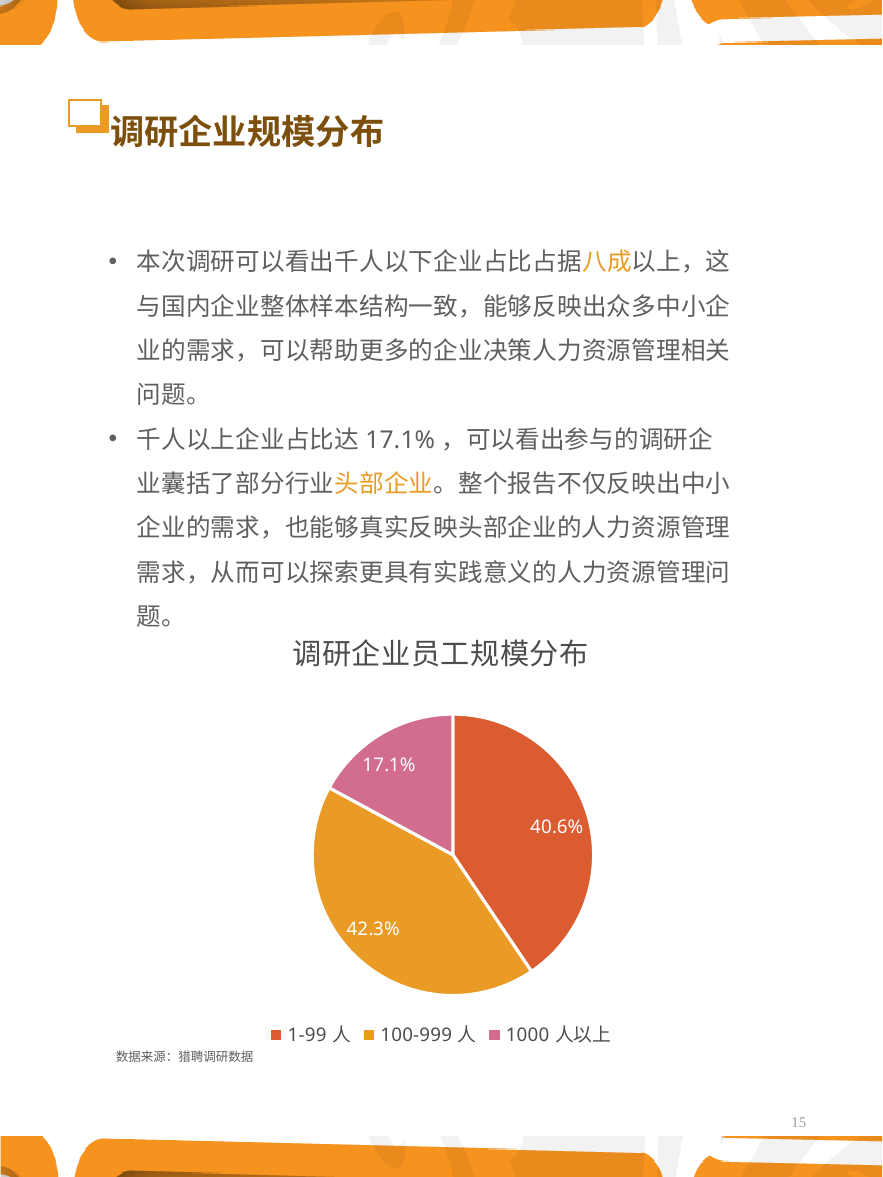
How many categories are listed in the legend? 3 What share of surveyed companies have 1-99 employees (1-99 人)? 40.6% What is the title of the chart? 调研企业员工规模分布 What is the combined share of companies with fewer than 1000 employees (1-99 人 and 100-999 人)? 82.9% What share of surveyed companies have 1000 or more employees (1000 人以上)? 17.1% Which company size category has the smallest share of the pie? 1000 人以上 What type of chart is shown on the slide? Pie chart What is the difference in percentage points between the 1-99 人 slice and the 1000 人以上 slice? 23.5 percentage points What is the difference in percentage points between the 100-999 人 slice and the 1-99 人 slice? 1.7 percentage points What share of surveyed companies have 100-999 employees (100-999 人)? 42.3% Which company size category has the largest share of the pie? 100-999 人 How many slices does the pie chart have? 3